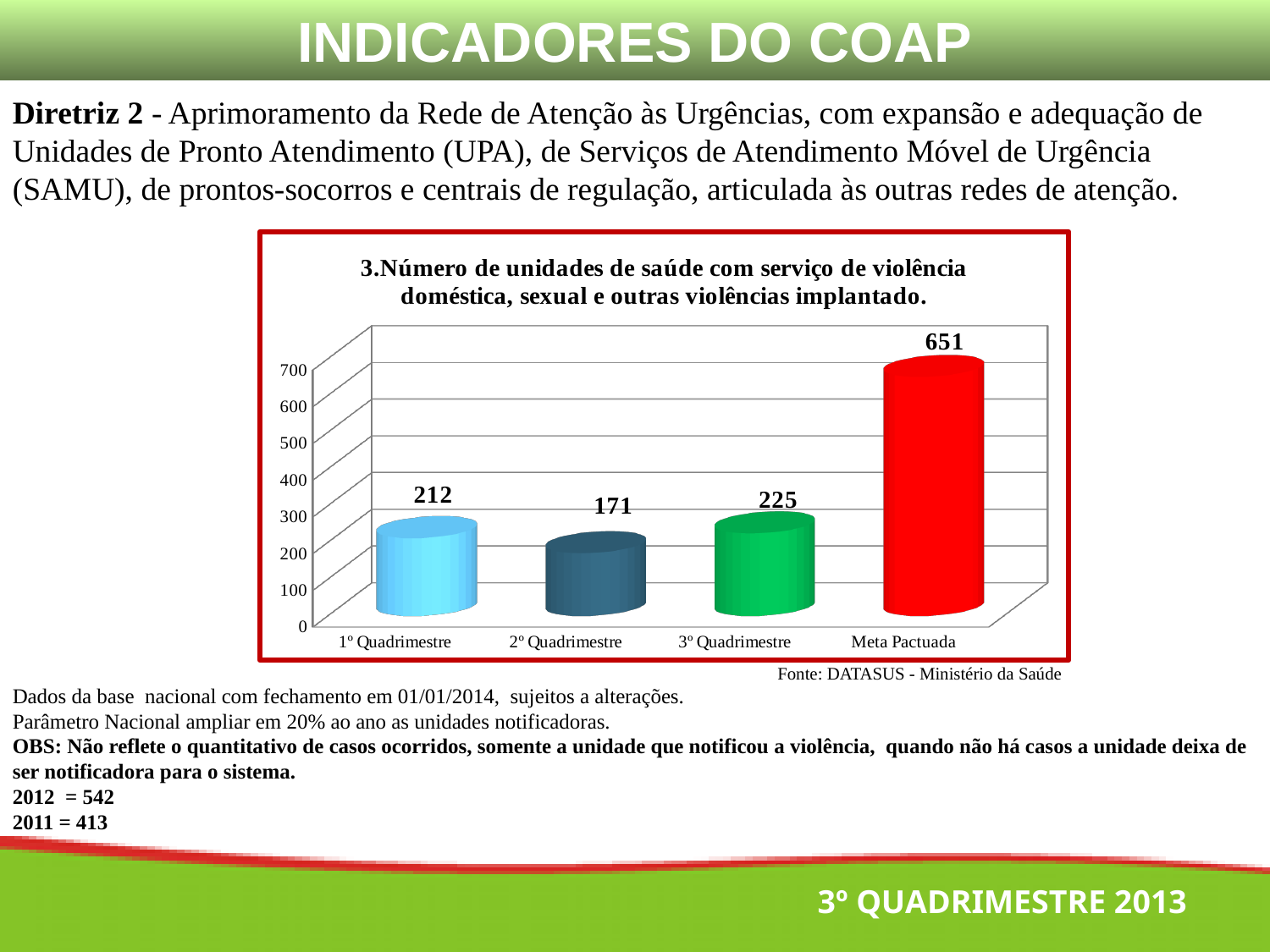
What is the value for 2º Quadrimestre? 171 What is the difference between the 1º Quadrimestre and 2º Quadrimestre values? 41 Which category has the highest value? Meta Pactuada What is the difference between the Meta Pactuada value and the 3º Quadrimestre value? 426 What is the value for 3º Quadrimestre? 225 Which is larger, the value for 1º Quadrimestre or the value for 3º Quadrimestre? 3º Quadrimestre What is the value for Meta Pactuada? 651 What colour is the bar for Meta Pactuada? Red How many categories are shown on the x axis? 4 Which category has the lowest value? 2º Quadrimestre What kind of chart is shown on the slide? Bar chart What is the value for 1º Quadrimestre? 212